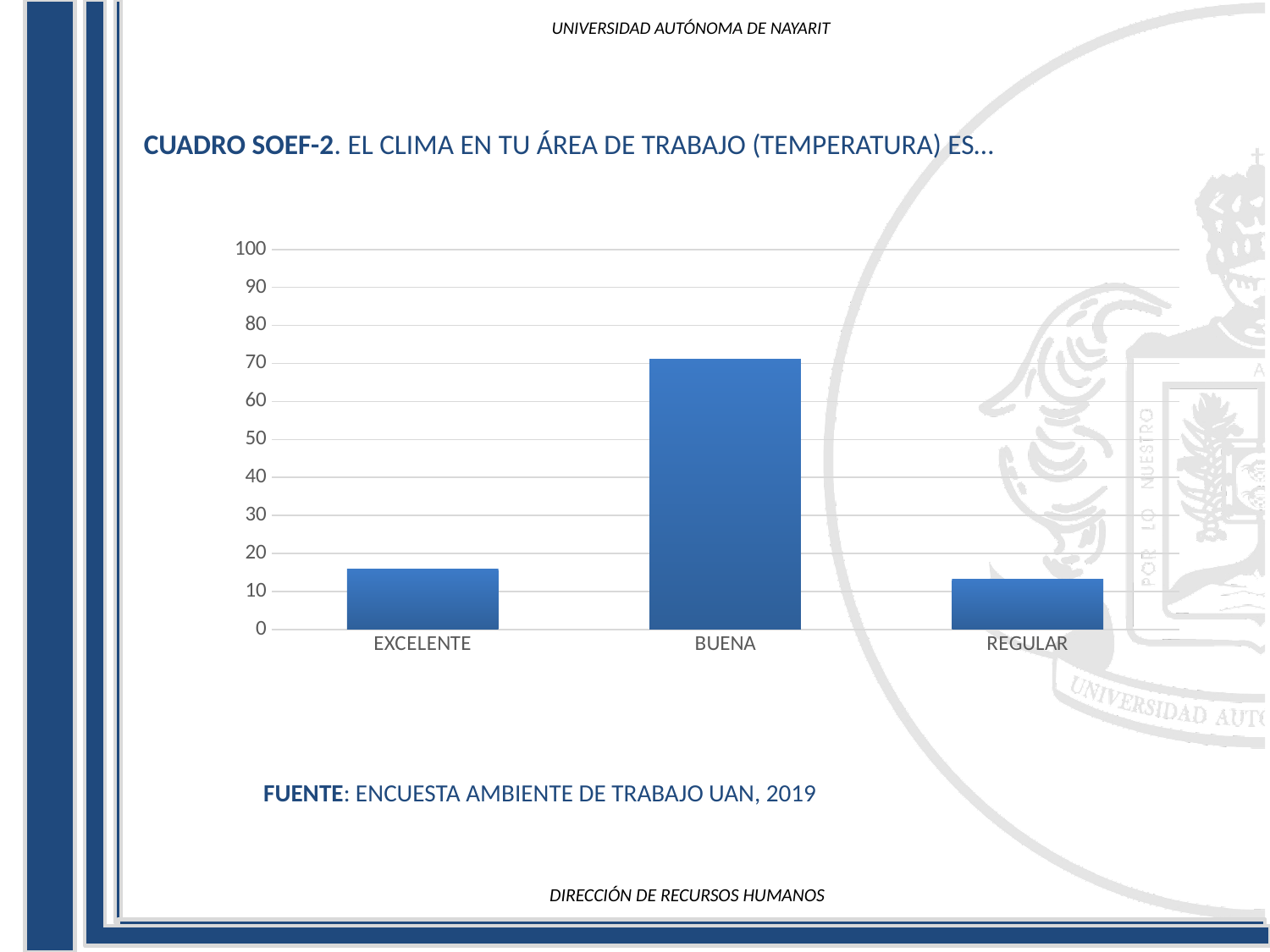
Which category has the highest bar in the chart? BUENA Is the value for REGULAR greater or less than 20? less What kind of chart is shown on the slide? bar chart Is the value for EXCELENTE greater or less than 20? less Is the value for BUENA greater or less than 60? greater What is the title of the chart on the slide? CUADRO SOEF-2. EL CLIMA EN TU ÁREA DE TRABAJO (TEMPERATURA) ES… What is the maximum value shown on the y axis of the chart? 100 Which is larger, the value for BUENA or the value for EXCELENTE? BUENA Which is larger, the value for REGULAR or the value for BUENA? BUENA How many categories are shown on the x axis of the chart? 3